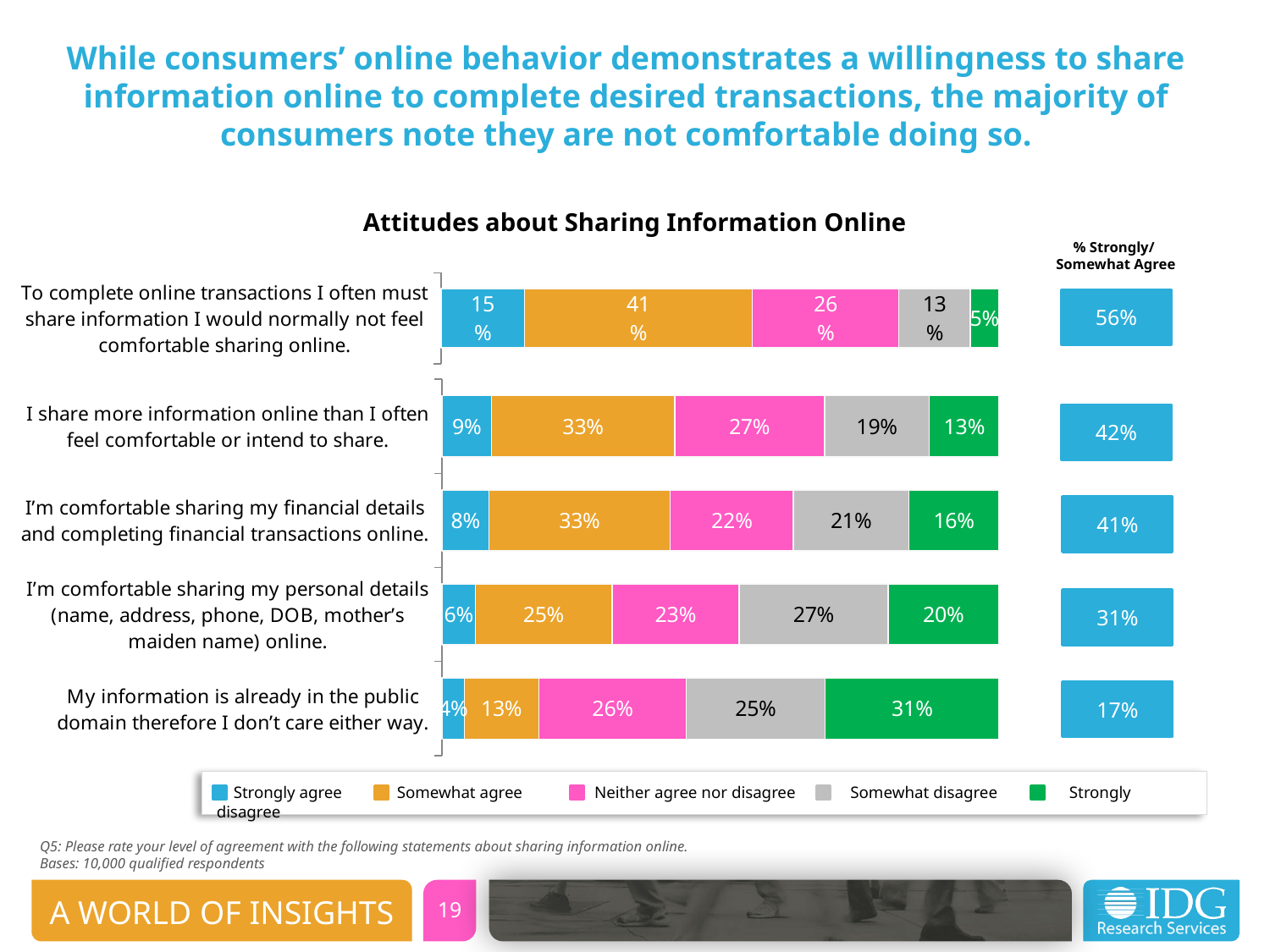
How many statements are plotted in the chart? 5 Which statement has the lowest 'Strongly agree' percentage? My information is already in the public domain therefore I don't care either way. What is the title of the chart? Attitudes about Sharing Information Online What is the difference in the 'Somewhat disagree' percentage between the personal details statement (27%) and the financial details statement (21%)? 6 percentage points What is the '% Strongly/Somewhat Agree' value shown for 'I'm comfortable sharing my personal details (name, address, phone, DOB, mother's maiden name) online'? 31% What percentage 'Strongly disagree' with the statement 'My information is already in the public domain therefore I don't care either way'? 31% What is the 'Neither agree nor disagree' value for 'I'm comfortable sharing my financial details and completing financial transactions online'? 22% Which statement has the highest 'Strongly agree' percentage? To complete online transactions I often must share information I would normally not feel comfortable sharing online. Which has a larger 'Strongly disagree' share: the statement about sharing personal details or the statement about sharing financial details? Sharing personal details What percentage of respondents 'Somewhat agree' with the statement 'I share more information online than I often feel comfortable or intend to share'? 33% How many series does the legend of the chart list? 5 What type of chart is shown on the slide? Stacked bar chart